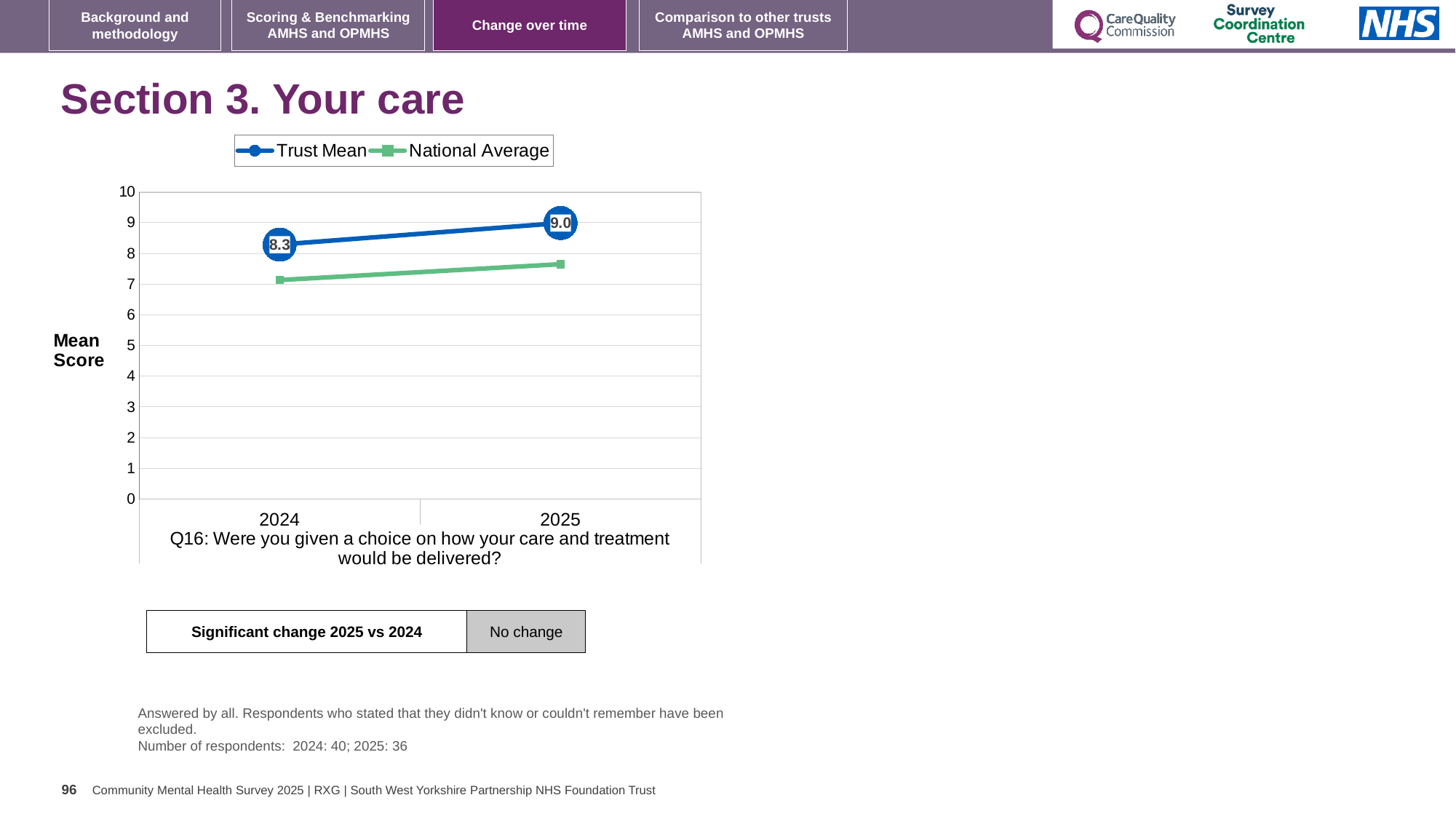
By how much did the Trust Mean change from 2024 to 2025? 0.7 What is the Trust Mean score for 2025? 9.0 Is the National Average for 2025 greater or less than 7? greater Does the Trust Mean rise or fall from 2024 to 2025? rise Which year has the higher Trust Mean score? 2025 Which year has the lower Trust Mean score? 2024 What is the Trust Mean score for 2024? 8.3 What kind of chart is shown on the slide? line chart Is the National Average for 2024 greater or less than 8? less In 2025, which is larger: the Trust Mean or the National Average? Trust Mean How many years are shown on the x axis? 2 How many series does the legend list? 2